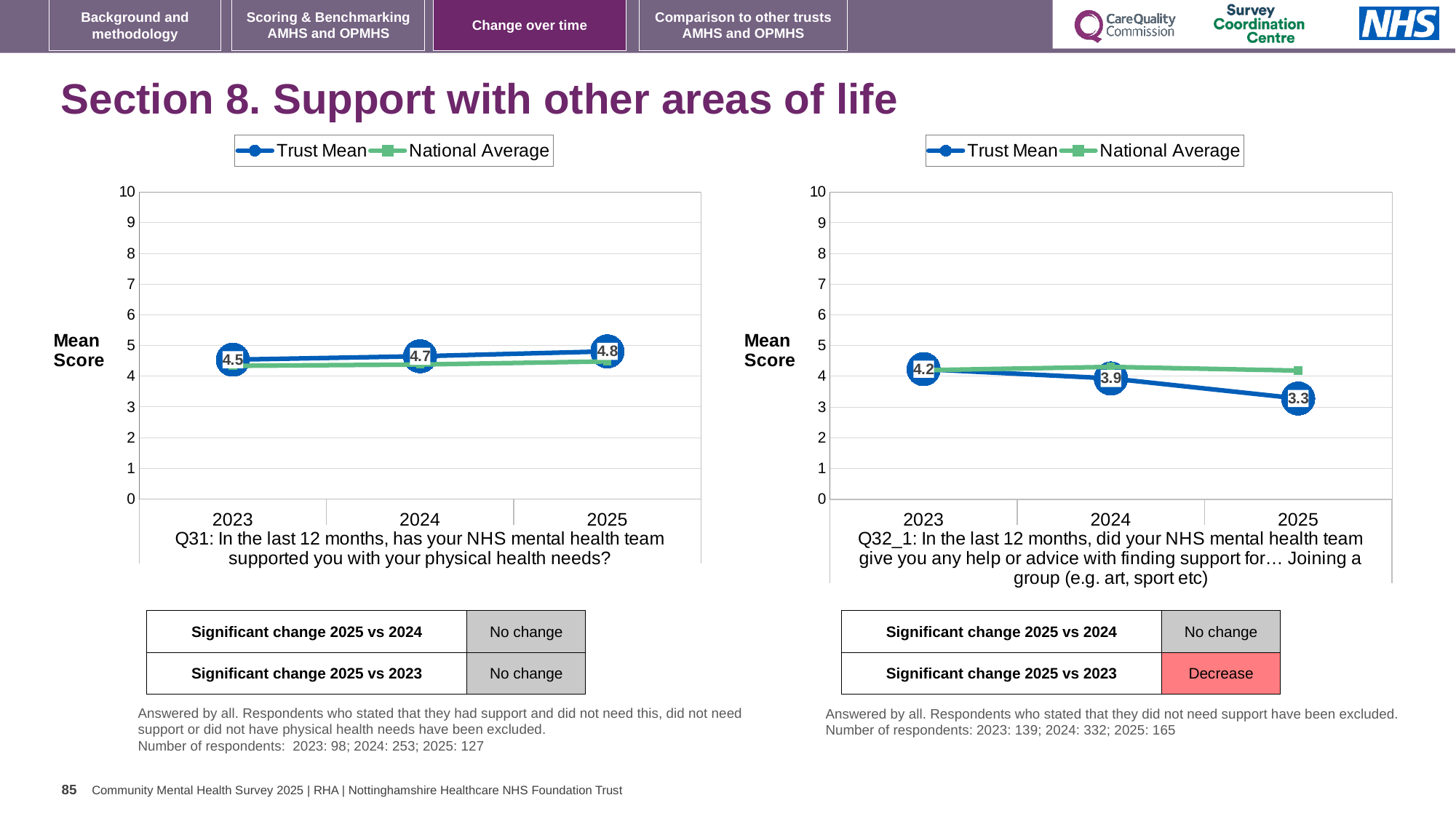
In the left chart (Q31), what is the difference between the Trust Mean in 2025 and in 2023? 0.3 In the right chart (Q32_1), which year has the lowest Trust Mean? 2025 In the right chart (Q32_1), what is the Trust Mean for 2024? 3.9 How many series does the legend of the left chart (Q31) list? 2 In the right chart (Q32_1), what is the difference between the Trust Mean in 2023 and in 2025? 0.9 In the left chart (Q31), what is the Trust Mean for 2025? 4.8 What kind of chart is the right chart (Q32_1)? line chart In the left chart (Q31), which year has the highest Trust Mean? 2025 Does the Trust Mean in the right chart (Q32_1) rise or fall from 2023 to 2025? fall Does the Trust Mean in the left chart (Q31) rise or fall from 2023 to 2025? rise In the right chart (Q32_1), what is the Trust Mean for 2025? 3.3 In the left chart (Q31), what is the Trust Mean for 2023? 4.5